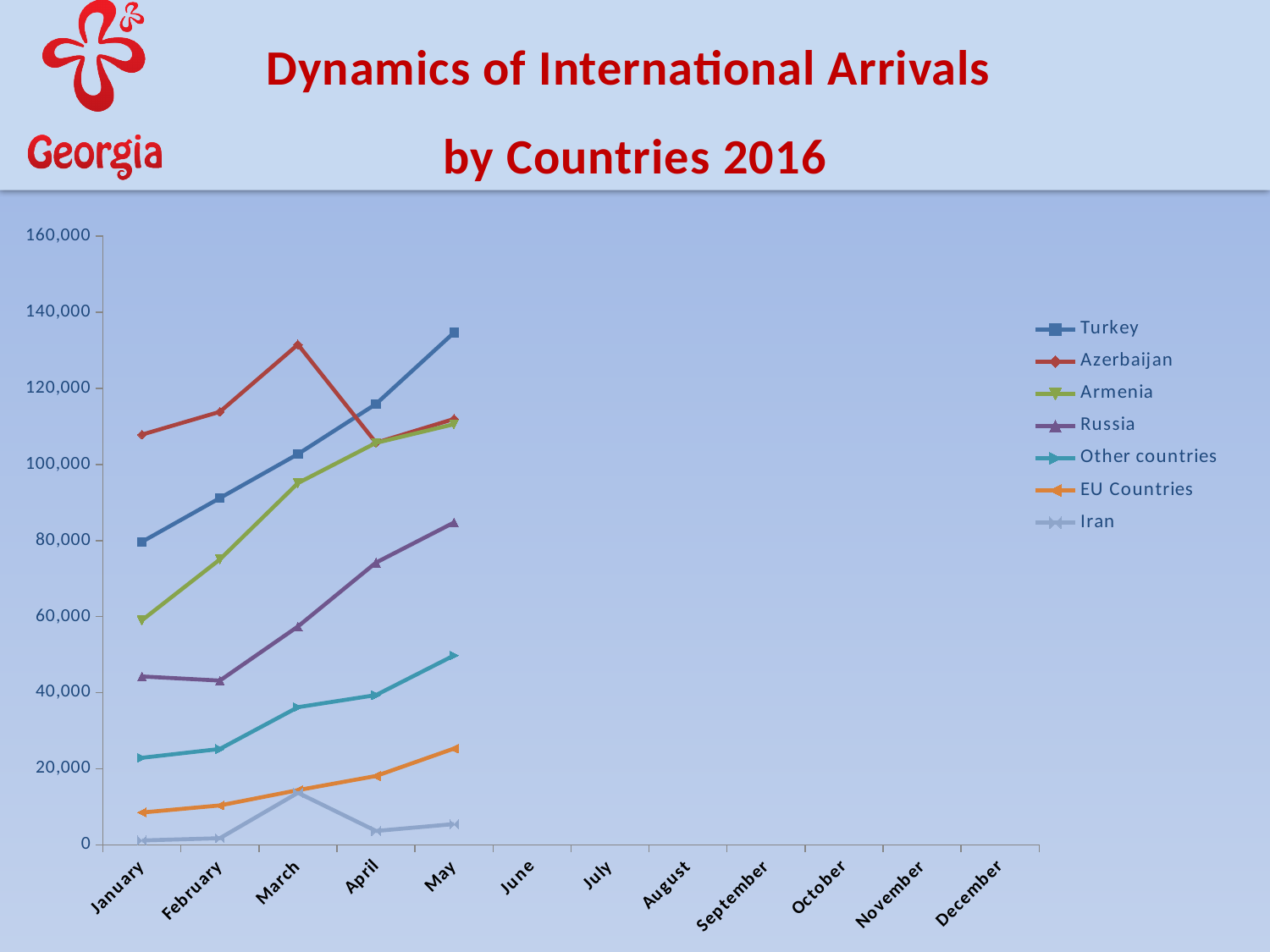
Which country or group has the highest number of arrivals in January? Azerbaijan Is the value for Russia in January greater or less than 60,000? less How many series does the legend list? 7 Does the Turkey line rise or fall from January to May? rises Is the value for Turkey in May greater or less than 120,000? greater How many months are shown along the x axis? 12 In which month does the Azerbaijan line reach its peak? March Which country or group has the highest number of arrivals in May? Turkey What is the title of the chart on the slide? Dynamics of International Arrivals by Countries 2016 What kind of chart is shown on the slide? line chart Which is larger in March, the value for Azerbaijan or the value for Turkey? Azerbaijan Which country or group has the lowest number of arrivals in May? Iran